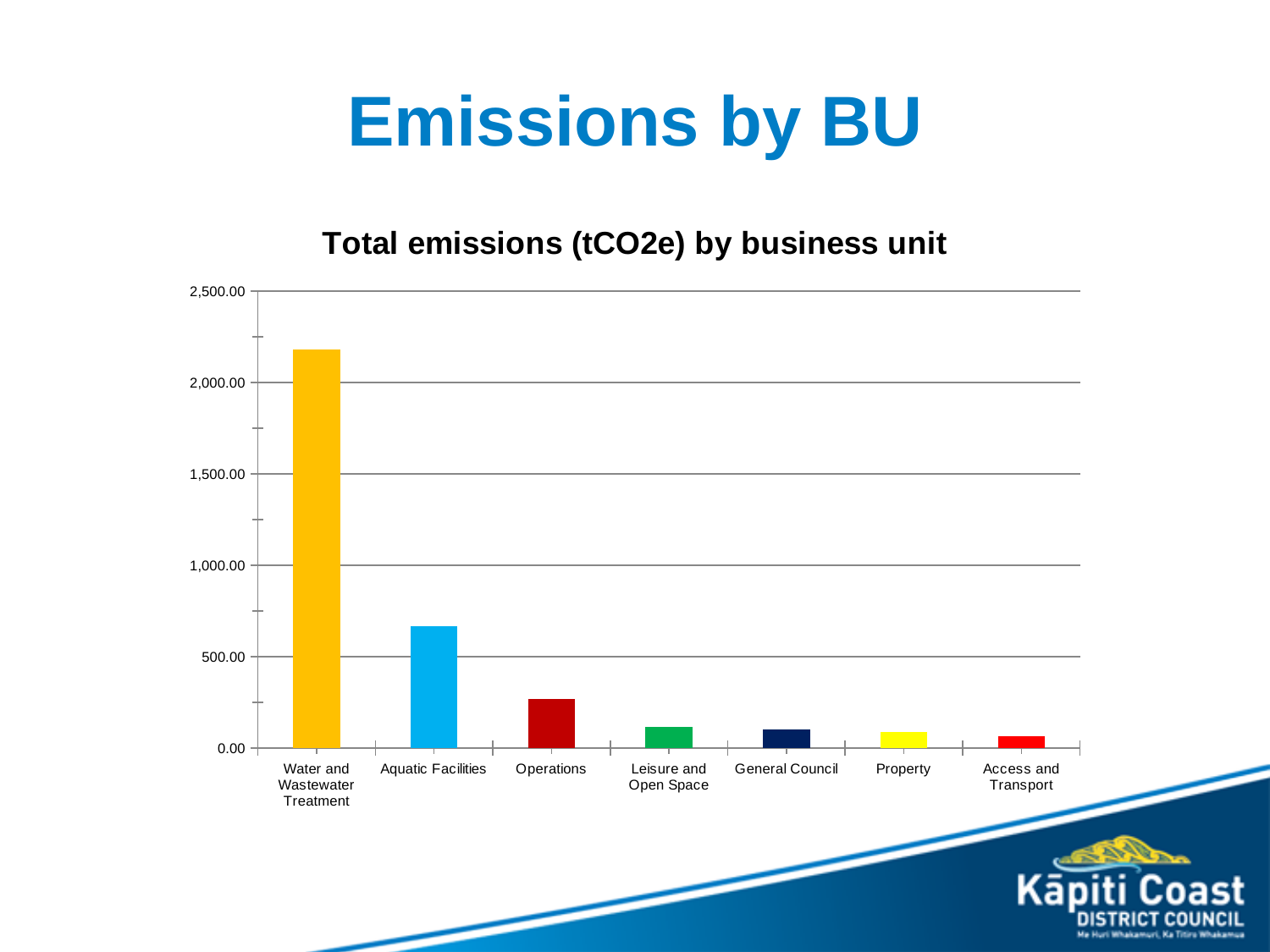
Which has higher emissions, Operations or Leisure and Open Space? Operations What is the title of the chart? Total emissions (tCO2e) by business unit What type of chart is shown on the slide? bar chart Which business unit has the highest total emissions? Water and Wastewater Treatment Which has higher emissions, Aquatic Facilities or Operations? Aquatic Facilities Is the value for Operations greater or less than 500.00? less How many business units are shown on the x axis of the chart? 7 What colour is the bar for Water and Wastewater Treatment? orange/yellow Do the bar values generally rise or fall moving from left to right along the x axis? fall Is the value for Aquatic Facilities greater or less than 500.00? greater Is the value for Aquatic Facilities greater or less than 1,000.00? less